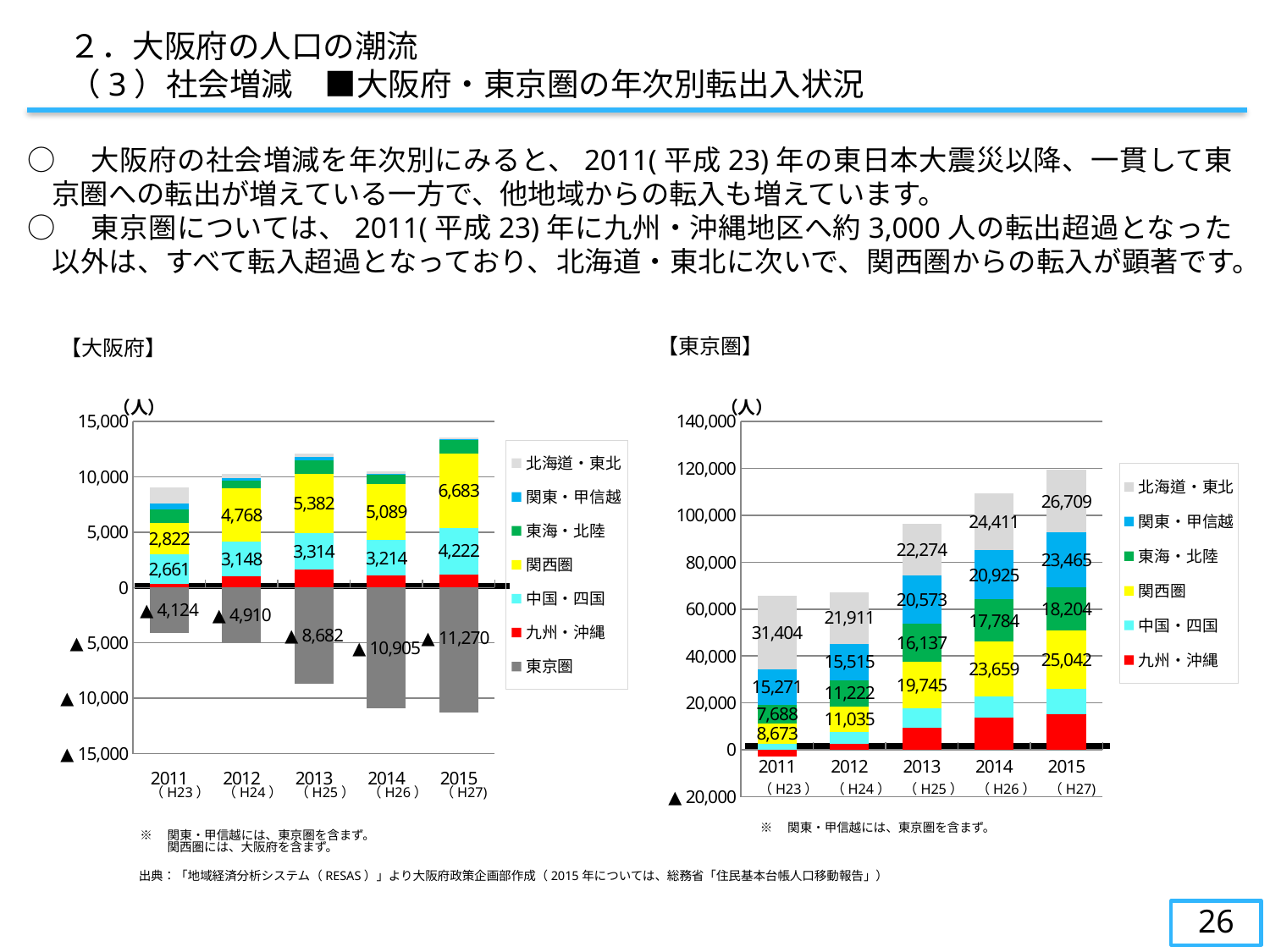
In the 【東京圏】 chart, how many series does the legend list? 6 In the 【大阪府】 chart, what is the difference between the 関西圏 values for 2015 and 2011? 3,861 In the 【大阪府】 chart, how many years are shown on the x axis? 5 In the 【東京圏】 chart, what is the value for 関東・甲信越 in 2015? 23,465 In the 【東京圏】 chart, which is larger in 2013: 関東・甲信越 or 関西圏? 関東・甲信越 In the 【大阪府】 chart, which year has the highest value for 関西圏? 2015 What type of chart is the 【東京圏】 chart? Stacked bar chart In the 【東京圏】 chart, what is the value for 東海・北陸 in 2014? 17,784 In the 【大阪府】 chart, what is the value for 関西圏 in 2015? 6,683 In the 【東京圏】 chart, what is the value for 北海道・東北 in 2011? 31,404 In the 【大阪府】 chart, what is the value for 東京圏 in 2014? ▲10,905 In the 【大阪府】 chart, what is the value for 中国・四国 in 2013? 3,314